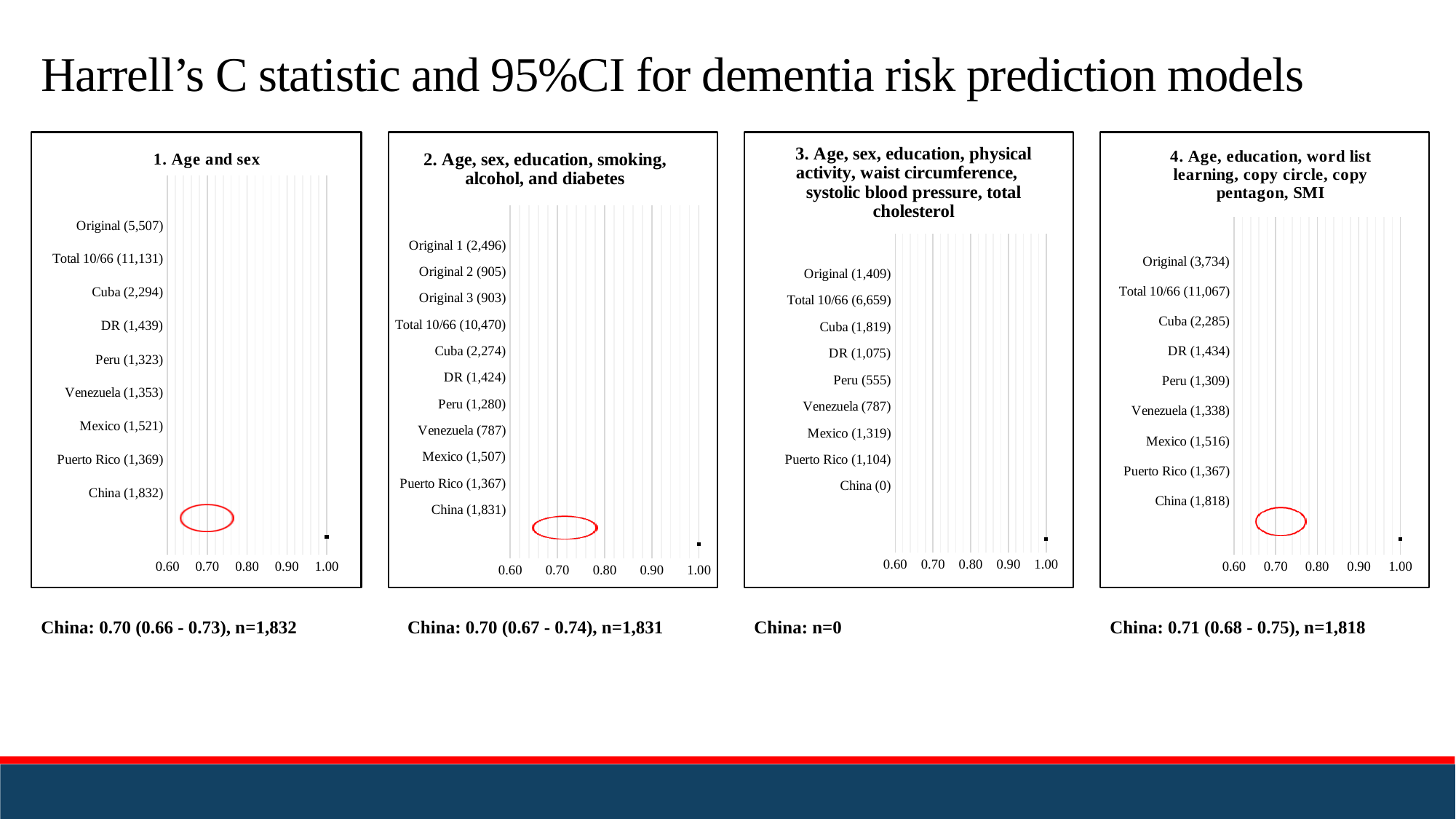
In the chart titled "2. Age, sex, education, smoking, alcohol, and diabetes", what sample size is shown in parentheses for Total 10/66? 10,470 In the chart titled "1. Age and sex", which category has the largest sample size shown in parentheses? Total 10/66 (11,131) In the chart titled "1. Age and sex", what sample size is shown in parentheses for China? 1,832 What is the lowest tick value shown on the x axis of the chart titled "1. Age and sex"? 0.60 In the chart titled "2. Age, sex, education, smoking, alcohol, and diabetes", what sample size is shown in parentheses for Venezuela? 787 What is the highest tick value shown on the x axis of the chart titled "4. Age, education, word list learning, copy circle, copy pentagon, SMI"? 1.00 How many categories are listed on the y axis of the chart titled "4. Age, education, word list learning, copy circle, copy pentagon, SMI"? 9 How many categories are listed on the y axis of the chart titled "2. Age, sex, education, smoking, alcohol, and diabetes"? 11 According to the text below the chart titled "4. Age, education, word list learning, copy circle, copy pentagon, SMI", what is the Harrell's C statistic for China? 0.71 In the third chart from the left, what sample size is shown in parentheses for China? 0 According to the text below the chart titled "1. Age and sex", what is the Harrell's C statistic for China? 0.70 How many categories are listed on the y axis of the chart titled "1. Age and sex"? 9